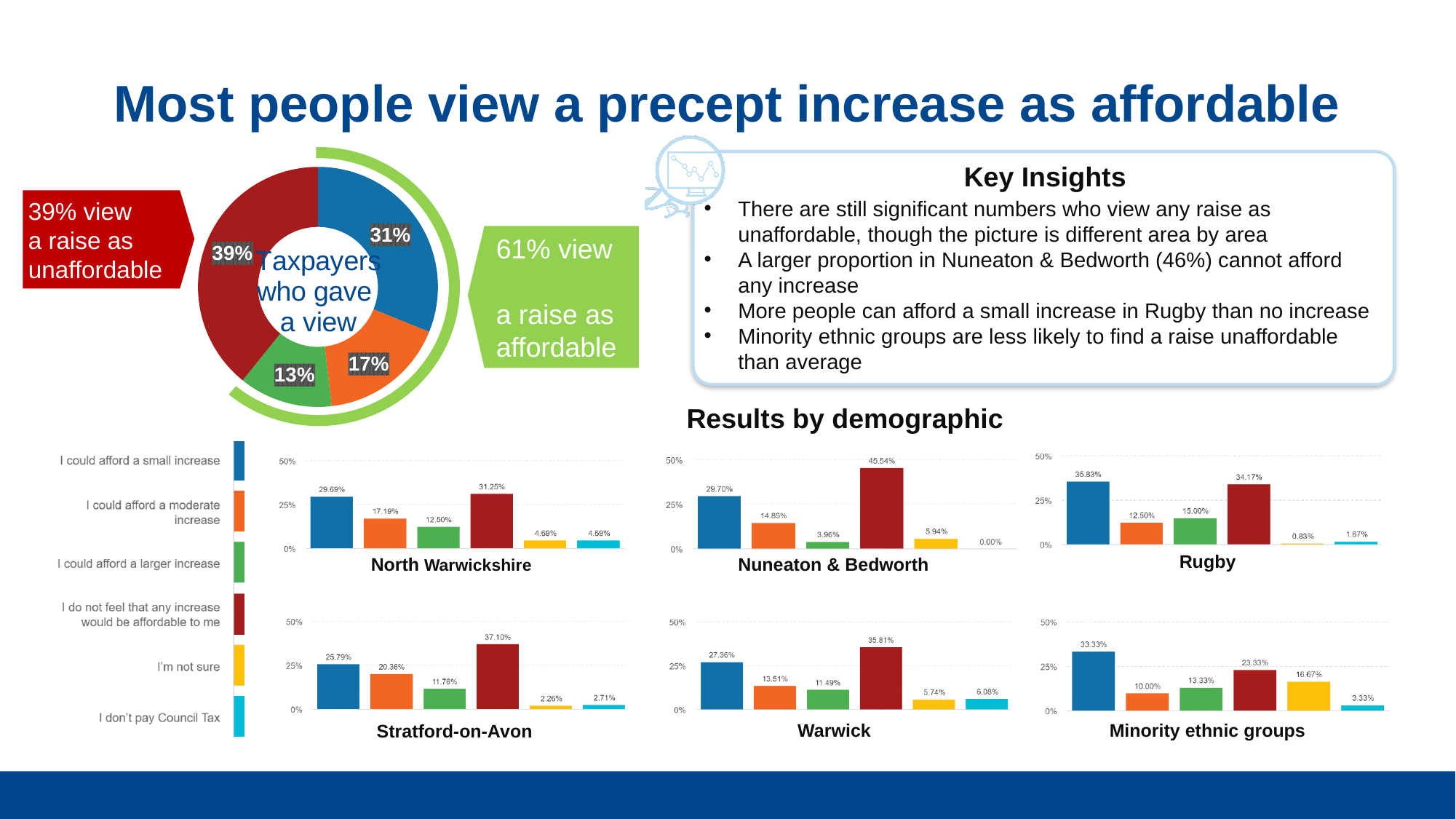
In the Minority ethnic groups chart, what is the value for 'I'm not sure'? 16.67% In the Nuneaton & Bedworth chart, is the value for 'I could afford a small increase' greater or less than 25%? greater What kind of chart is used for the Rugby results? bar chart In the Stratford-on-Avon chart, which category has the highest value? I do not feel that any increase would be affordable to me In the donut chart 'Taxpayers who gave a view', what percentage is shown for the largest (dark red) segment? 39% In the Nuneaton & Bedworth chart, which category has the lowest value? I don't pay Council Tax How many categories are plotted in the Warwick chart? 6 In the Nuneaton & Bedworth chart, what is the value for 'I do not feel that any increase would be affordable to me'? 45.54% In the North Warwickshire chart, which is larger: 'I could afford a small increase' or 'I do not feel that any increase would be affordable to me'? I do not feel that any increase would be affordable to me In the Warwick chart, what is the difference between 'I do not feel that any increase would be affordable to me' (35.81%) and 'I could afford a small increase' (27.36%)? 8.45% In the Rugby chart, what is the value for 'I could afford a small increase'? 35.83% In the donut chart 'Taxpayers who gave a view', what is the smallest segment's value? 13%